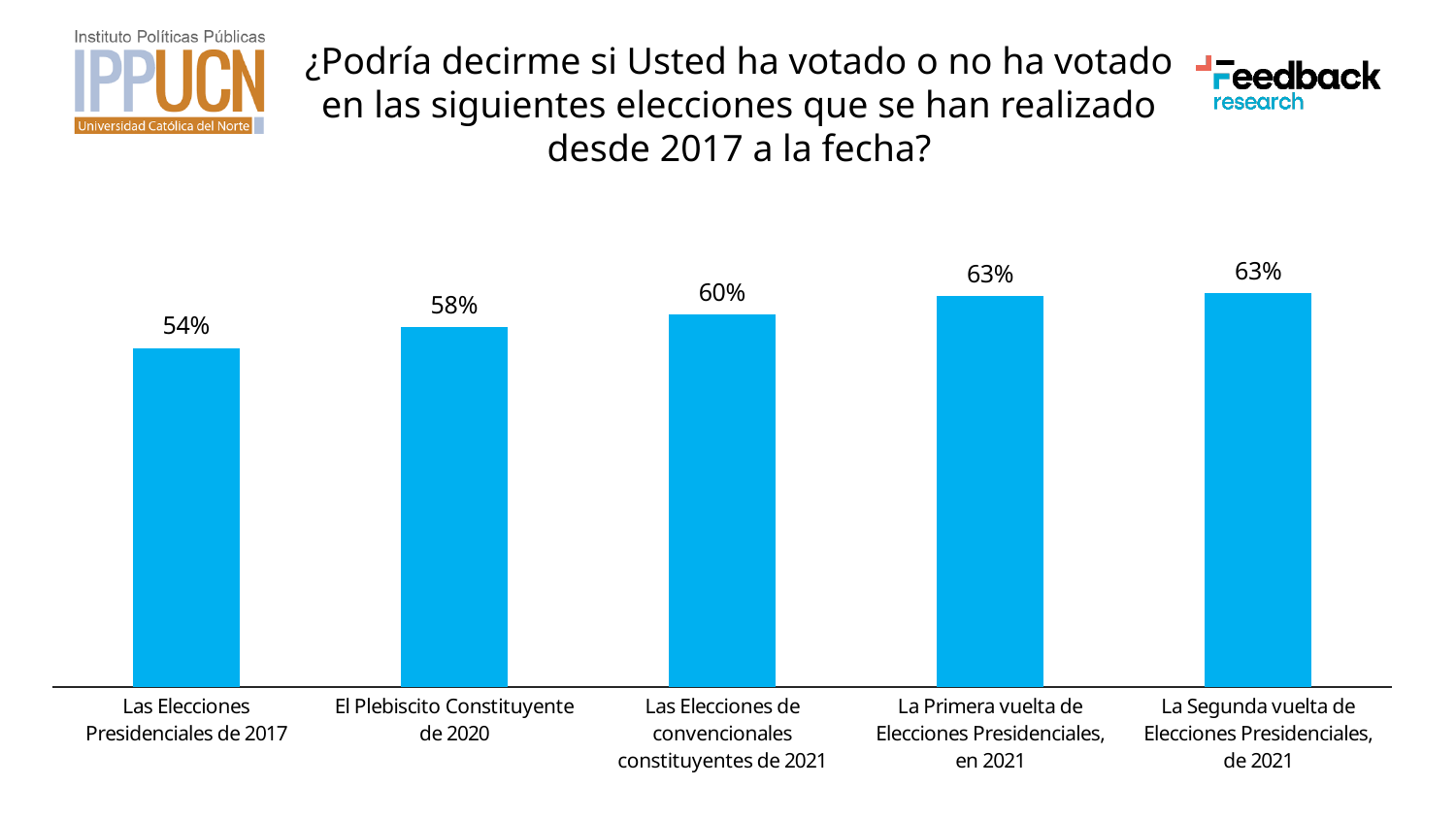
What percentage is shown for La Primera vuelta de Elecciones Presidenciales, en 2021? 63% What percentage is shown for Las Elecciones Presidenciales de 2017? 54% Do the percentages rise or fall from left to right across the chart? Rise What kind of chart is shown on the slide? Bar chart What is the difference between the percentage for Las Elecciones de convencionales constituyentes de 2021 and El Plebiscito Constituyente de 2020? 2% What percentage is shown for El Plebiscito Constituyente de 2020? 58% Which is larger: the percentage for El Plebiscito Constituyente de 2020 or for Las Elecciones Presidenciales de 2017? El Plebiscito Constituyente de 2020 What is the difference between the percentage for La Segunda vuelta de Elecciones Presidenciales, de 2021 and Las Elecciones Presidenciales de 2017? 9% Which election has the lowest percentage? Las Elecciones Presidenciales de 2017 What colour are the bars in the chart? Blue How many elections are shown in the chart? 5 What percentage is shown for Las Elecciones de convencionales constituyentes de 2021? 60%